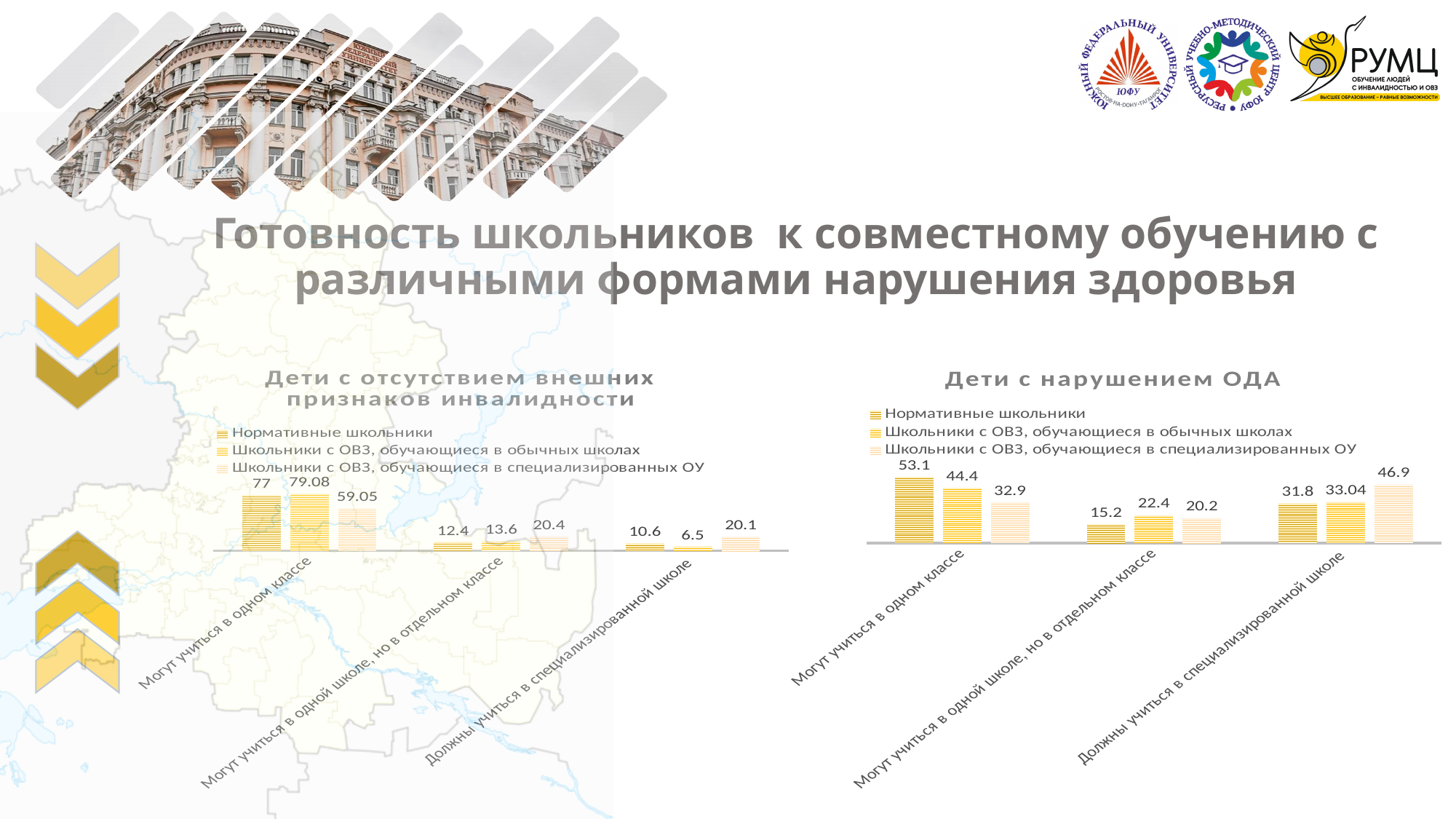
What type of chart is 'Дети с нарушением ОДА'? Bar chart How many categories are shown on the x axis of the chart 'Дети с нарушением ОДА'? 3 In the chart 'Дети с отсутствием внешних признаков инвалидности', what is the value for 'Школьники с ОВЗ, обучающиеся в специализированных ОУ' in the category 'Должны учиться в специализированной школе'? 20.1 In the chart 'Дети с отсутствием внешних признаков инвалидности', which series has the lowest value in the category 'Должны учиться в специализированной школе'? Школьники с ОВЗ, обучающиеся в обычных школах In the chart 'Дети с нарушением ОДА', what is the value for 'Школьники с ОВЗ, обучающиеся в обычных школах' in the category 'Могут учиться в одной школе, но в отдельном классе'? 22.4 How many series does the legend of the chart 'Дети с отсутствием внешних признаков инвалидности' list? 3 In the chart 'Дети с отсутствием внешних признаков инвалидности', what is the difference between the values for 'Школьники с ОВЗ, обучающиеся в обычных школах' and 'Нормативные школьники' in the category 'Могут учиться в одном классе'? 2.08 In the chart 'Дети с отсутствием внешних признаков инвалидности', what is the value for 'Школьники с ОВЗ, обучающиеся в специализированных ОУ' in the category 'Могут учиться в одном классе'? 59.05 In the chart 'Дети с нарушением ОДА', what is the difference between the values for 'Нормативные школьники' and 'Школьники с ОВЗ, обучающиеся в специализированных ОУ' in the category 'Могут учиться в одном классе'? 20.2 In the chart 'Дети с нарушением ОДА', which series has the highest value in the category 'Должны учиться в специализированной школе'? Школьники с ОВЗ, обучающиеся в специализированных ОУ In the chart 'Дети с нарушением ОДА', which is larger in the category 'Могут учиться в одной школе, но в отдельном классе': the value for 'Нормативные школьники' or for 'Школьники с ОВЗ, обучающиеся в специализированных ОУ'? Школьники с ОВЗ, обучающиеся в специализированных ОУ In the chart 'Дети с отсутствием внешних признаков инвалидности', what is the value for 'Нормативные школьники' in the category 'Могут учиться в одном классе'? 77